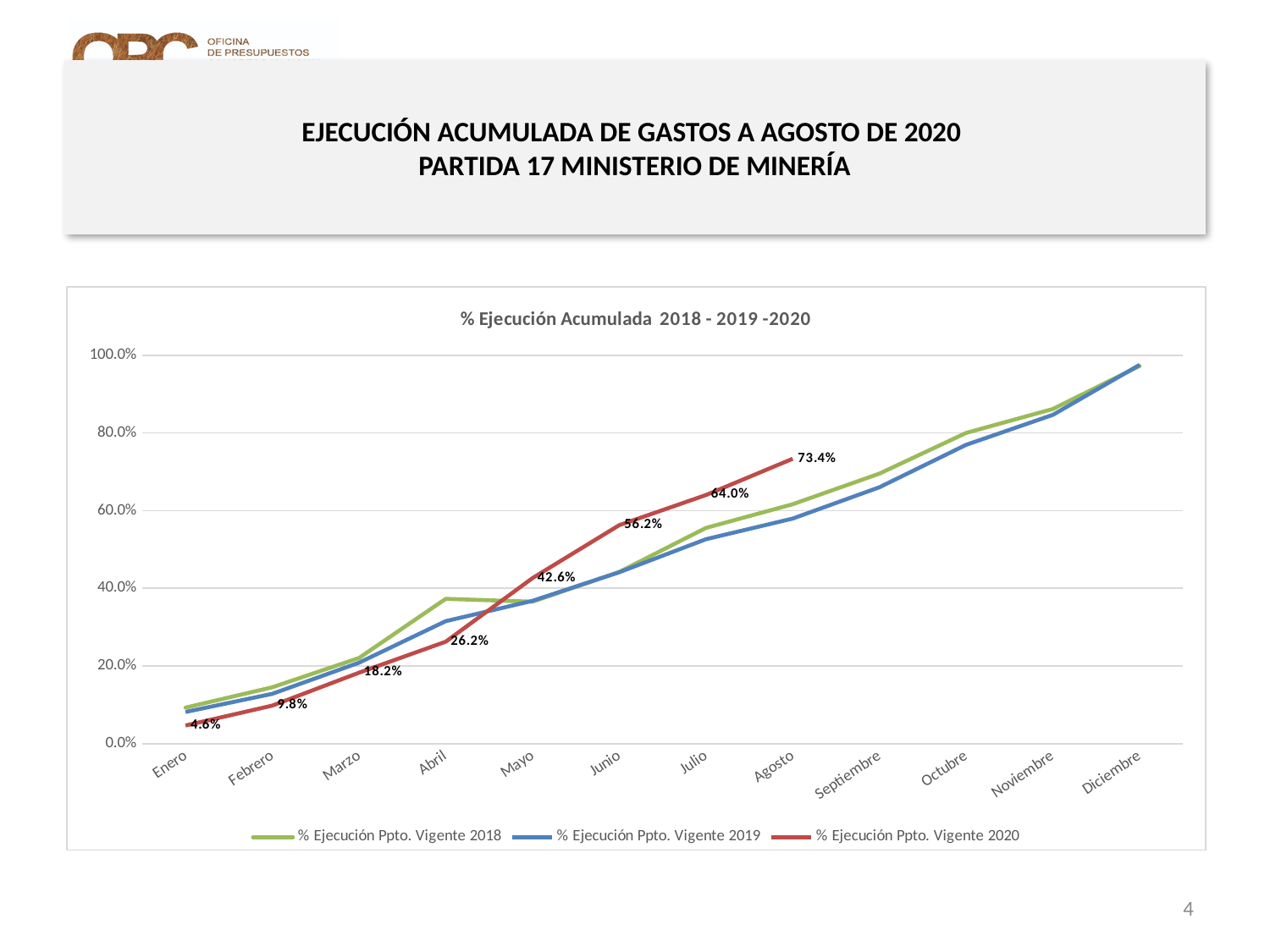
In Agosto, which series is higher: % Ejecución Ppto. Vigente 2020 or % Ejecución Ppto. Vigente 2019? % Ejecución Ppto. Vigente 2020 What is the value of % Ejecución Ppto. Vigente 2020 for Agosto? 73.4% What is the difference between the 2020 values for Junio and Mayo? 13.6 percentage points What is the value of % Ejecución Ppto. Vigente 2020 for Enero? 4.6% What is the value of % Ejecución Ppto. Vigente 2020 for Mayo? 42.6% Do the values of % Ejecución Ppto. Vigente 2020 rise or fall from Enero to Agosto? Rise Which month has the lowest labelled value for % Ejecución Ppto. Vigente 2020? Enero What kind of chart is shown on the slide? Line chart Is the value for % Ejecución Ppto. Vigente 2019 in Diciembre greater or less than 80.0%? greater What is the difference between the 2020 values for Agosto and Julio? 9.4 percentage points Which month has the highest labelled value for % Ejecución Ppto. Vigente 2020? Agosto How many series does the legend list? 3